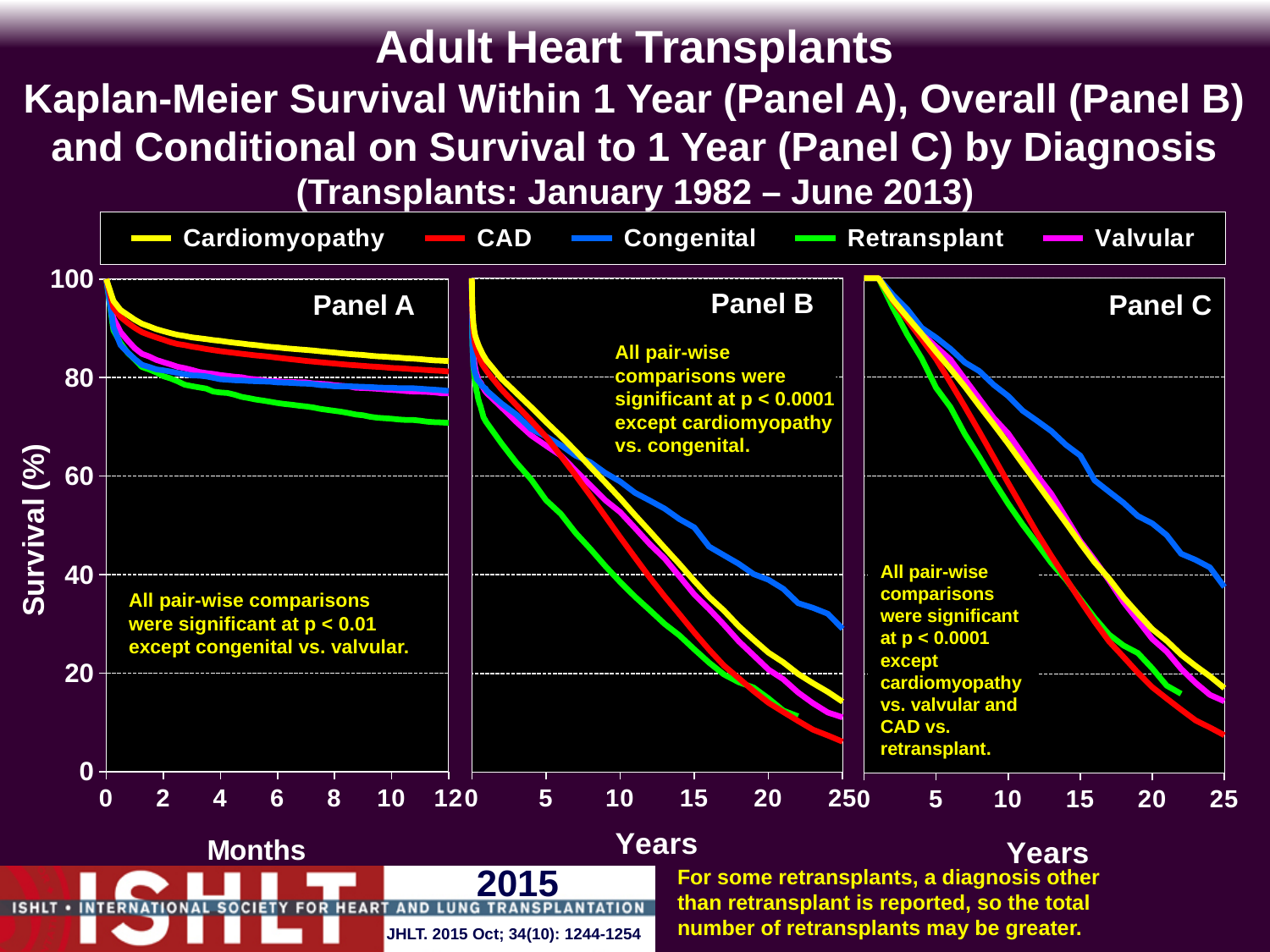
How many panels of survival curves are shown on the slide? 3 In Panel B, which diagnosis has the highest survival at 25 years? Congenital In Panel A, is the survival for Cardiomyopathy at 12 months greater or less than 80? greater What colour is used for the Congenital series in the legend? blue In Panel B, is the survival for Congenital at 25 years greater or less than 20? greater In Panel B, do the survival curves rise or fall as years increase? fall What kind of chart is shown in Panel A? line chart In Panel A, which diagnosis has the lowest survival at 12 months? Retransplant In Panel A, is the survival for Retransplant at 12 months greater or less than 80? less In Panel C, which diagnosis has the highest survival at 25 years? Congenital How many series does the legend list? 5 In Panel A, which diagnosis has the highest survival at 12 months? Cardiomyopathy